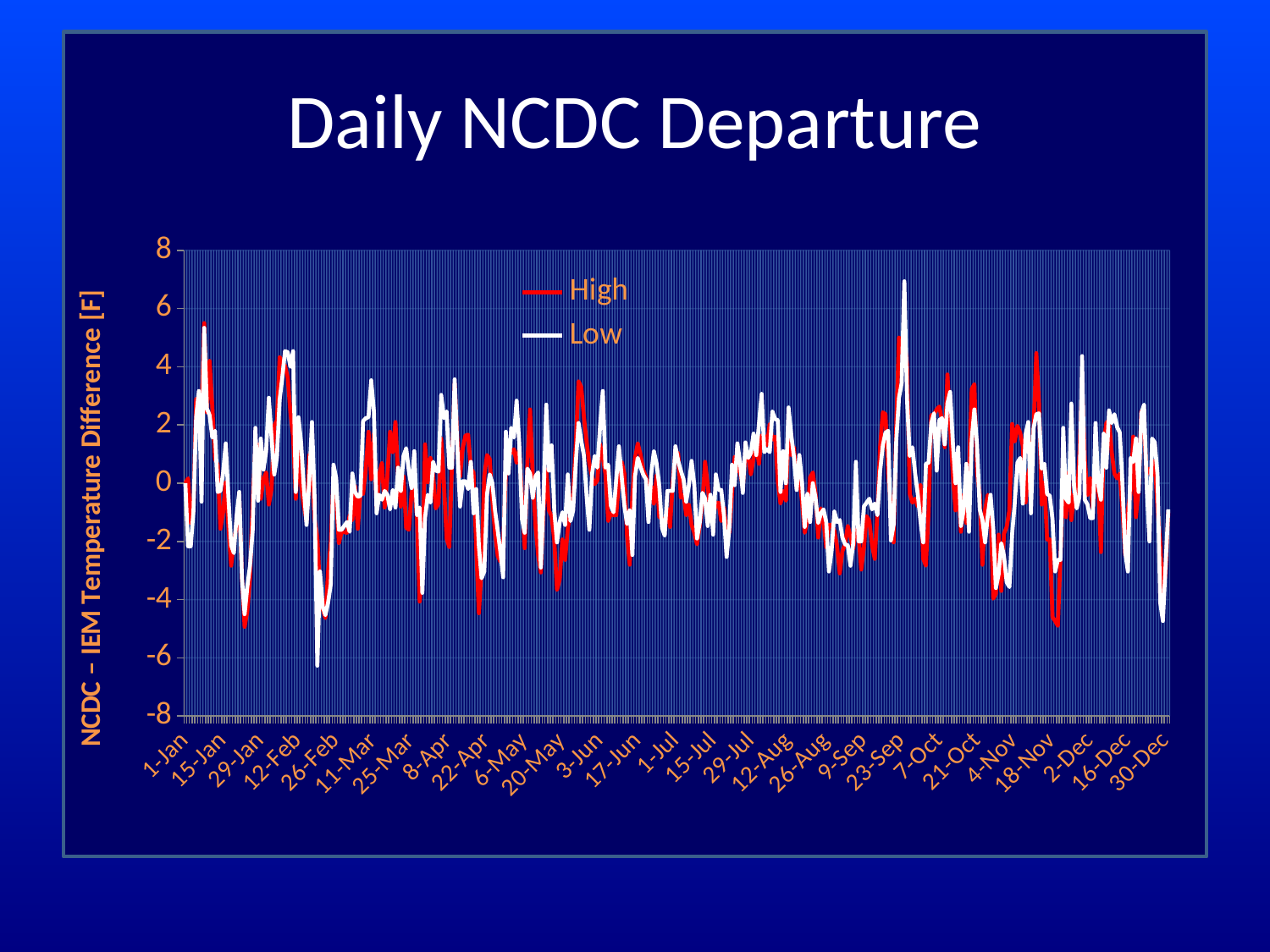
How many series does the legend list? 2 Which series reaches the lowest value anywhere on the chart? Low Is the highest value reached by the High series greater or less than 6? less Is the highest value reached by the Low series greater or less than 6? greater Which series reaches the highest value anywhere on the chart? Low How many date labels are shown along the x axis? 27 What is the title of the chart? Daily NCDC Departure Is the lowest value reached by the High series greater or less than -6? greater What kind of chart is shown on the slide? line chart What are the two series named in the legend? High and Low